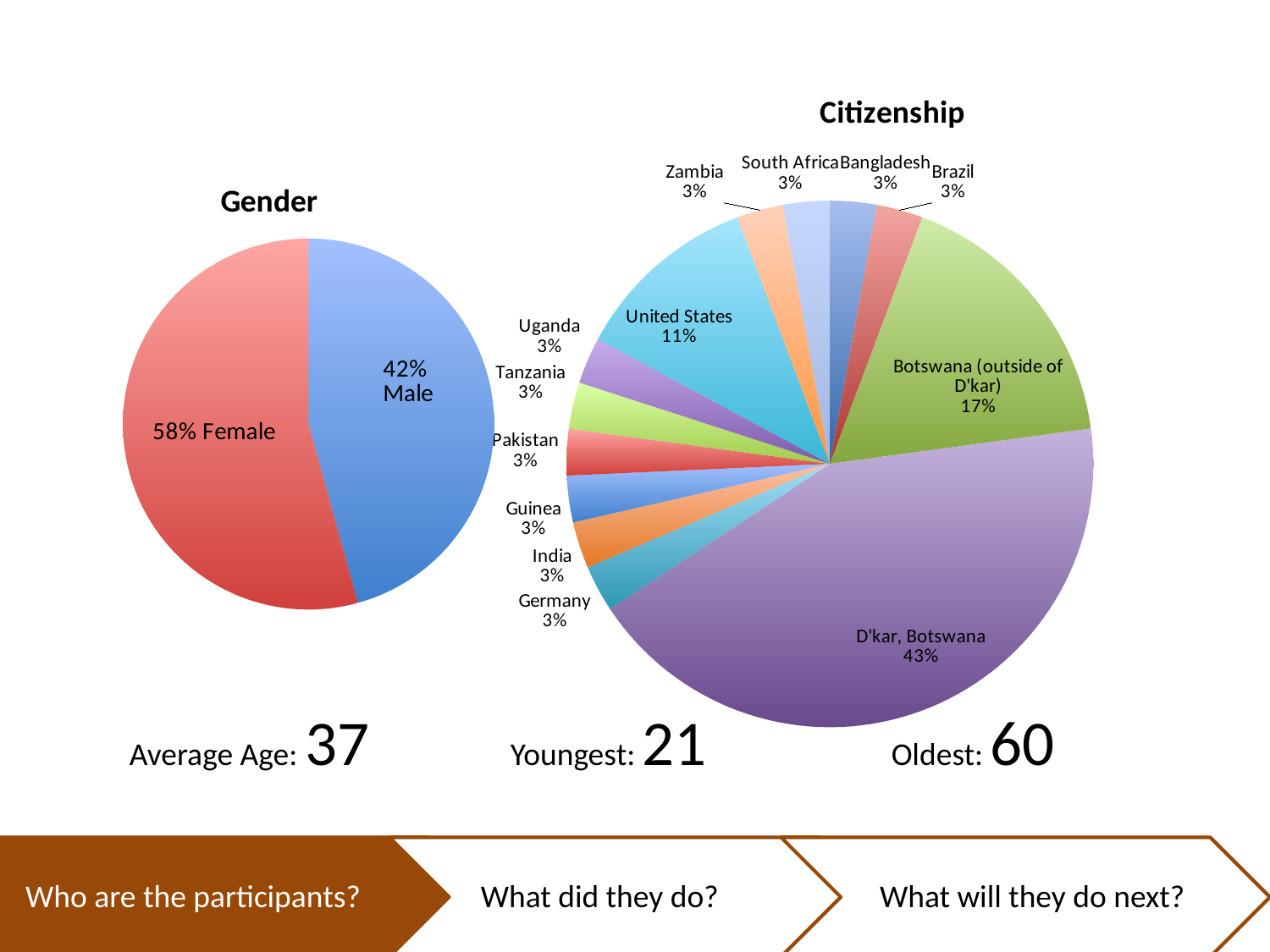
In the Gender chart, what share of participants are male? 42% In the Citizenship chart, which is larger, the United States share or the Zambia share? United States In the Citizenship chart, how many citizenship categories are shown? 13 In the Gender chart, what share of participants are female? 58% What kind of chart is the Citizenship chart? Pie chart In the Citizenship chart, which citizenship has the largest share? D'kar, Botswana In the Gender chart, what is the difference between the Female and Male shares? 16% In the Citizenship chart, what share of participants are from D'kar, Botswana? 43% In the Citizenship chart, what is the difference between the D'kar, Botswana share and the Botswana (outside of D'kar) share? 26% In the Citizenship chart, what share of participants are from the United States? 11% In the Citizenship chart, what share of participants are from Botswana (outside of D'kar)? 17% In the Gender chart, which group is larger, Female or Male? Female